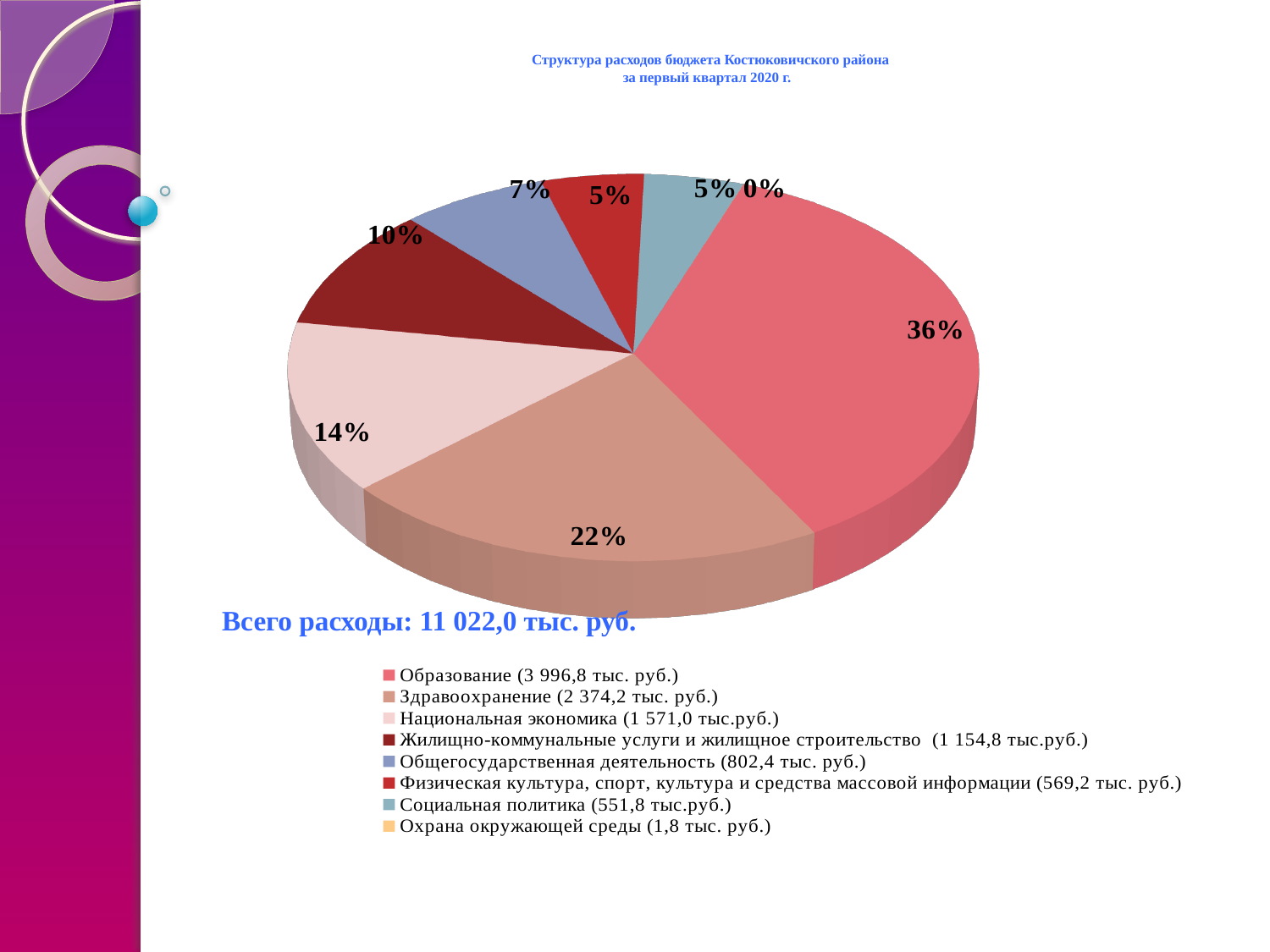
What percentage share of the pie does Образование have? 36% According to the legend, what is the amount for Здравоохранение? 2 374,2 тыс. руб. How many categories does the legend of the pie chart list? 8 What percentage share of the pie does Общегосударственная деятельность have? 7% According to the legend, what is the amount for Социальная политика? 551,8 тыс.руб. Which slice is larger: Национальная экономика or Жилищно-коммунальные услуги и жилищное строительство? Национальная экономика What percentage share of the pie does Здравоохранение have? 22% Which category has the largest slice of the pie? Образование What total expenditure is stated below the pie chart? 11 022,0 тыс. руб. What kind of chart is shown on the slide? pie chart Which category has the smallest slice of the pie? Охрана окружающей среды